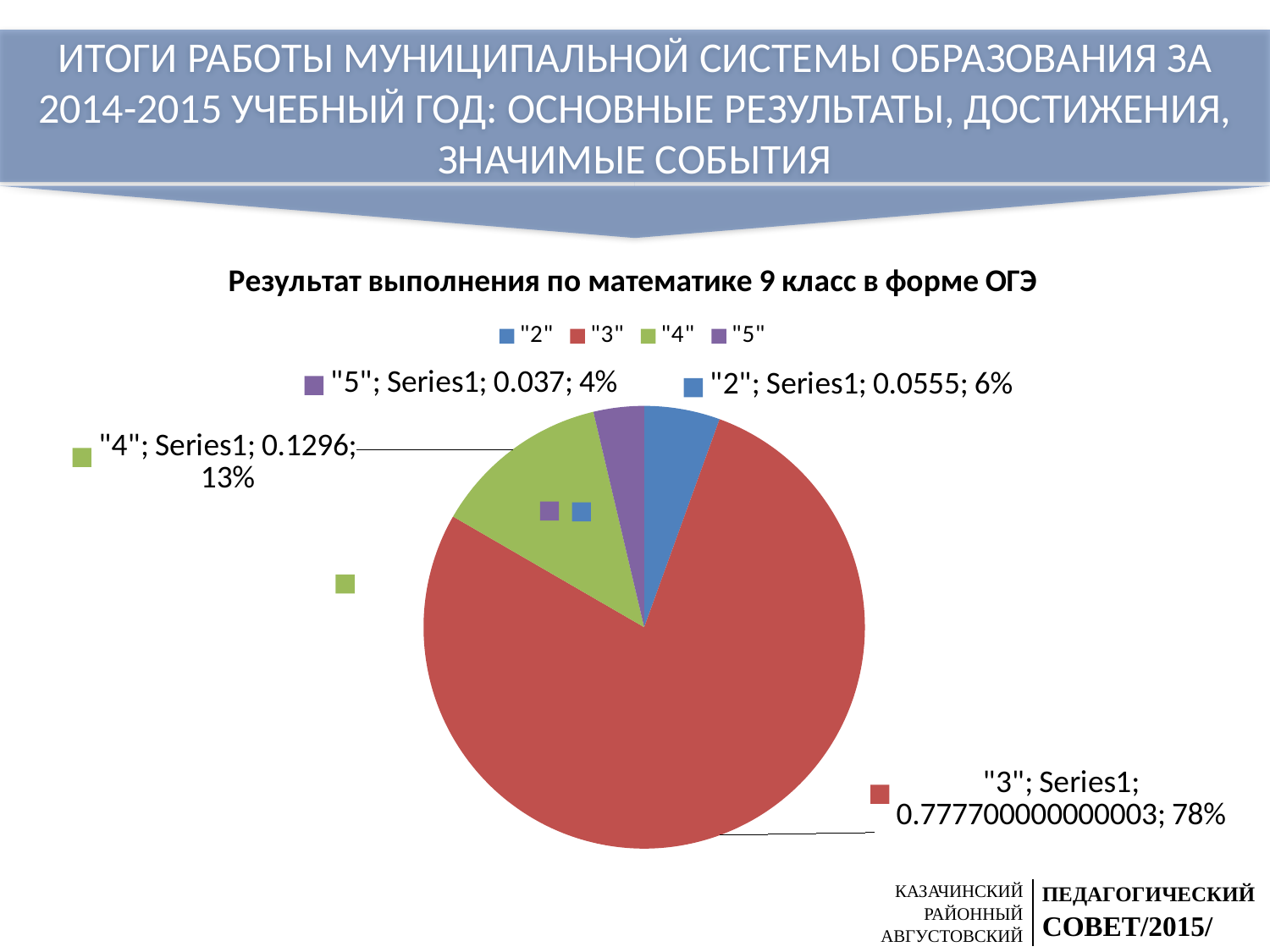
What is the value shown for the "4" category? 0.1296 What percentage share does the "2" slice have? 6% What percentage share does the "5" slice have? 4% Which slice is larger, "4" or "2"? "4" What is the value shown for the "2" category? 0.0555 Which category has the smallest slice? "5" What percentage share does the "4" slice have? 13% What is the title of the chart? Результат выполнения по математике 9 класс в форме ОГЭ How many slices does the pie chart have? 4 What kind of chart is shown on the slide? pie chart Which category has the largest slice? "3"